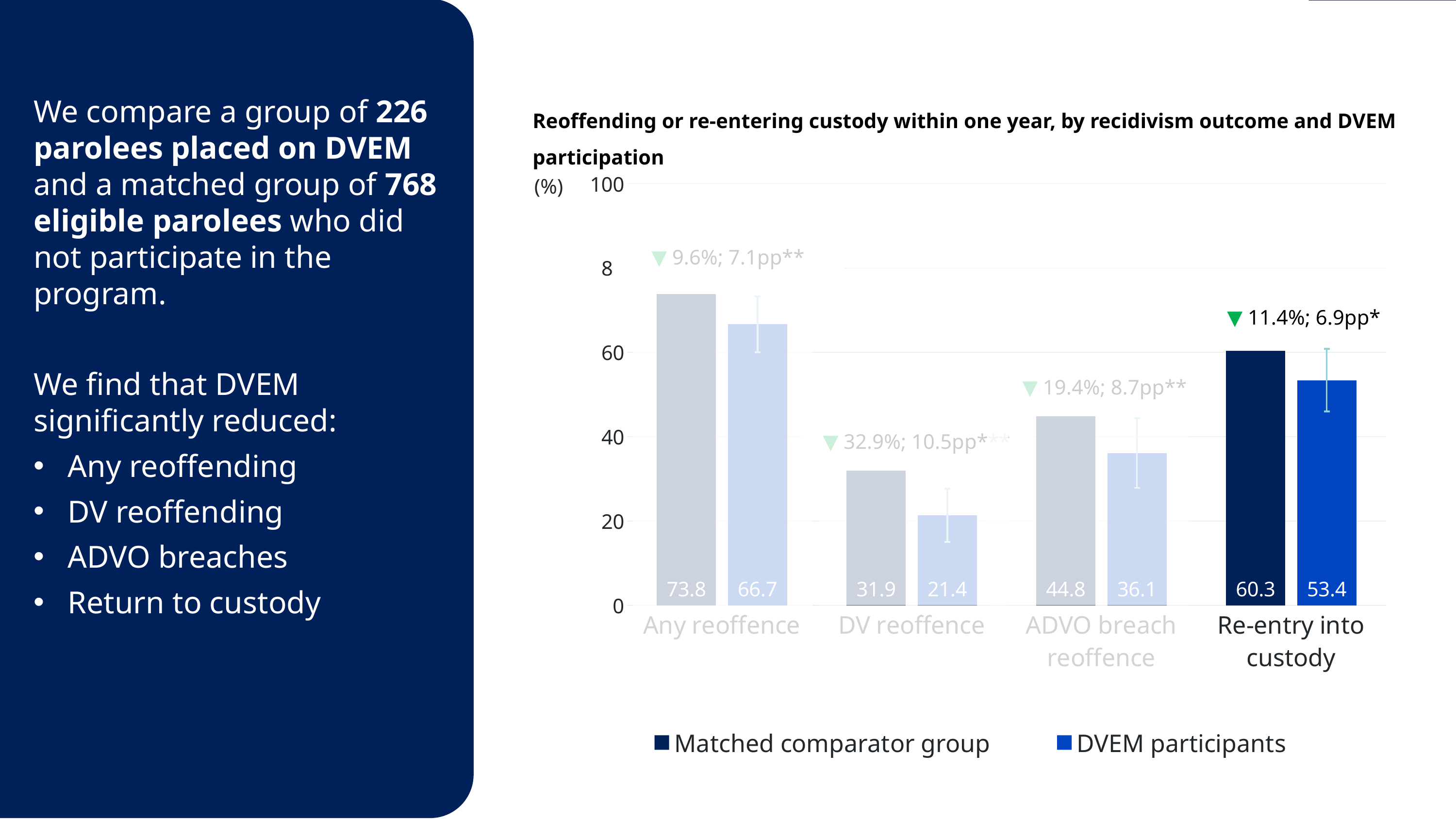
What is the value for DVEM participants for ADVO breach reoffence? 36.1 Which category has the highest value for the Matched comparator group? Any reoffence What is the value for DVEM participants for DV reoffence? 21.4 What is the value for the Matched comparator group for Any reoffence? 73.8 Which is larger for DV reoffence: the Matched comparator group or DVEM participants? Matched comparator group What is the difference between the Matched comparator group and DVEM participants for Re-entry into custody? 6.9 What kind of chart is shown on the slide? Bar chart How many categories are shown on the x axis? 4 How many series does the legend list? 2 What is the value for the Matched comparator group for Re-entry into custody? 60.3 What is the value for DVEM participants for Re-entry into custody? 53.4 Which category has the lowest value for DVEM participants? DV reoffence